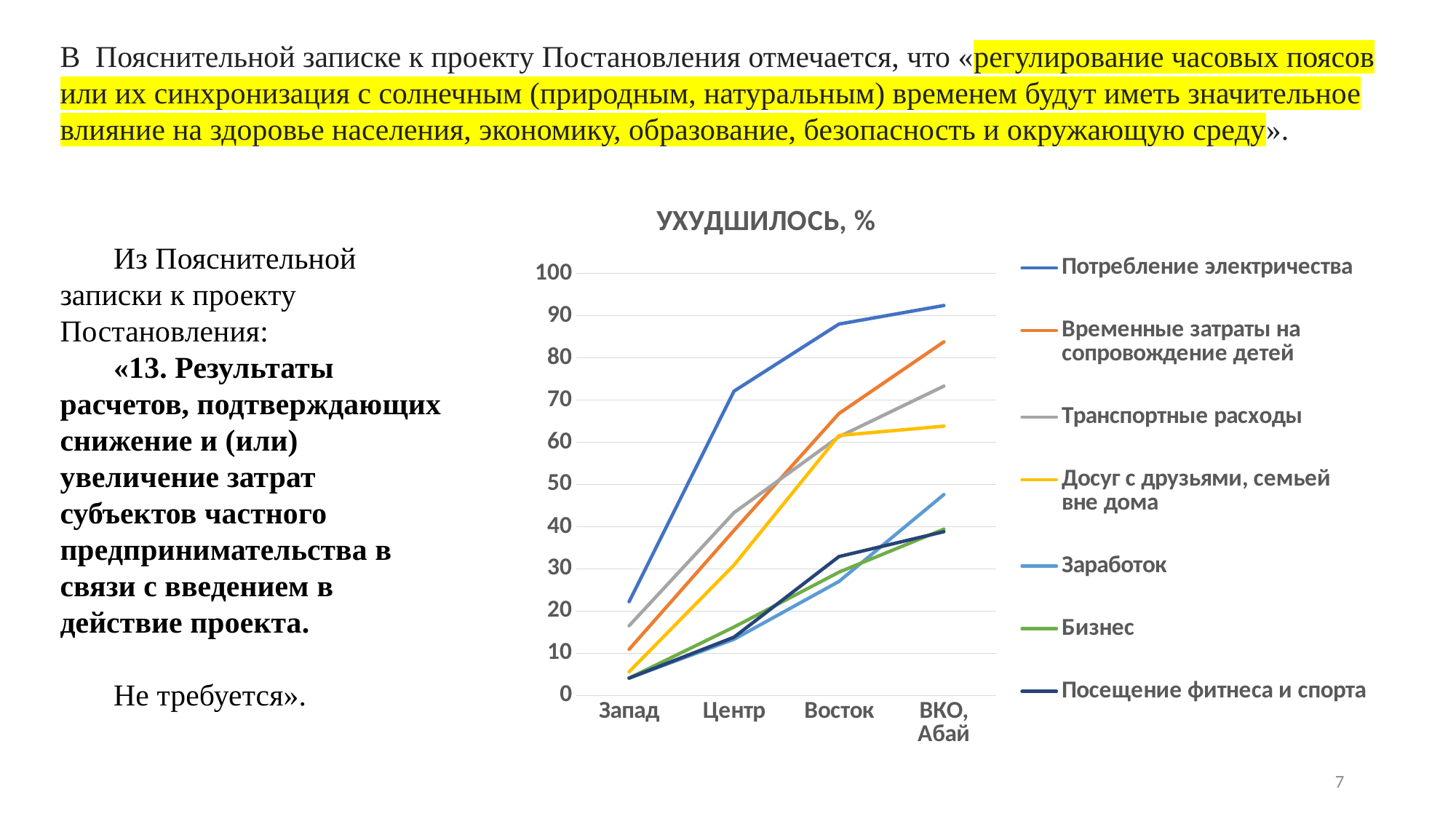
Which series has the highest value at Запад? Потребление электричества Do the values for Потребление электричества rise or fall from Запад to ВКО, Абай? rise At Центр, which is larger: Транспортные расходы or Досуг с друзьями, семьей вне дома? Транспортные расходы How many series does the legend of the chart list? 7 Which series has the highest value at Восток? Потребление электричества What is the title of the chart? УХУДШИЛОСЬ, % Is the value for Транспортные расходы at Восток greater or less than 50? greater How many categories are shown on the x axis of the chart? 4 Is the value for Временные затраты на сопровождение детей at ВКО, Абай greater or less than 70? greater What kind of chart is shown on the slide? line chart Is the value for Потребление электричества at Центр greater or less than 60? greater